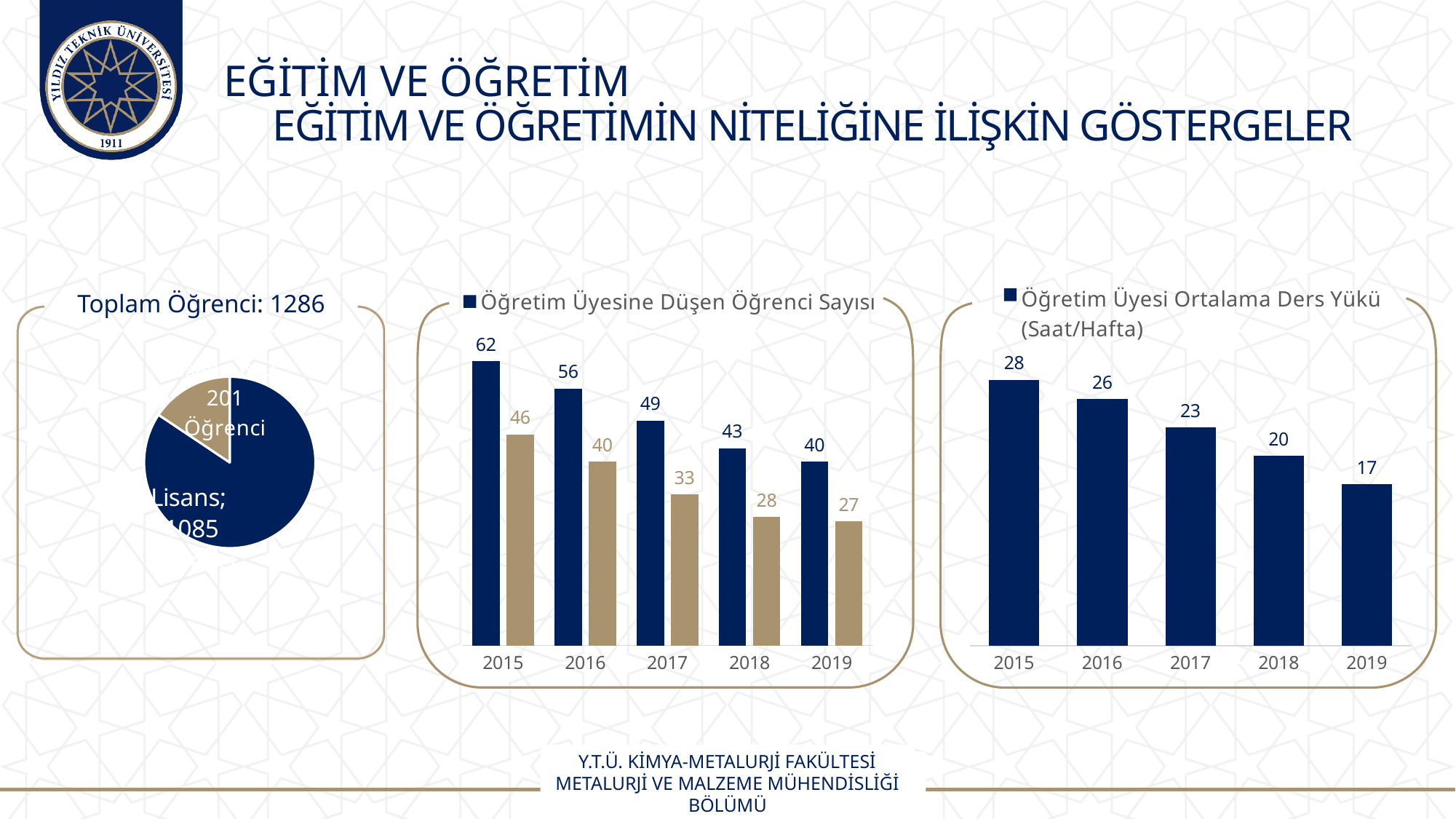
In the 'Öğretim Üyesi Ortalama Ders Yükü (Saat/Hafta)' chart, which year has the lowest value? 2019 In the 'Toplam Öğrenci: 1286' pie chart, which slice is larger: the Lisans slice or the 201 Öğrenci slice? Lisans In the 'Öğretim Üyesine Düşen Öğrenci Sayısı' chart, what is the value of the dark blue bar for 2017? 49 In the 'Öğretim Üyesine Düşen Öğrenci Sayısı' chart, which year has the highest dark blue bar? 2015 In the 'Toplam Öğrenci: 1286' pie chart, what is the value of the Lisans slice? 1085 In the 'Öğretim Üyesine Düşen Öğrenci Sayısı' chart, how many years are shown on the x axis? 5 What type of chart is the 'Toplam Öğrenci: 1286' chart? pie chart In the 'Öğretim Üyesine Düşen Öğrenci Sayısı' chart, what is the difference between the dark blue and tan bars for 2015? 16 In the 'Öğretim Üyesi Ortalama Ders Yükü (Saat/Hafta)' chart, what is the difference between the 2015 and 2019 values? 11 In the 'Öğretim Üyesi Ortalama Ders Yükü (Saat/Hafta)' chart, do the values rise or fall from 2015 to 2019? fall In the 'Öğretim Üyesine Düşen Öğrenci Sayısı' chart, what is the value of the tan bar for 2018? 28 In the 'Öğretim Üyesi Ortalama Ders Yükü (Saat/Hafta)' chart, what is the value for 2015? 28